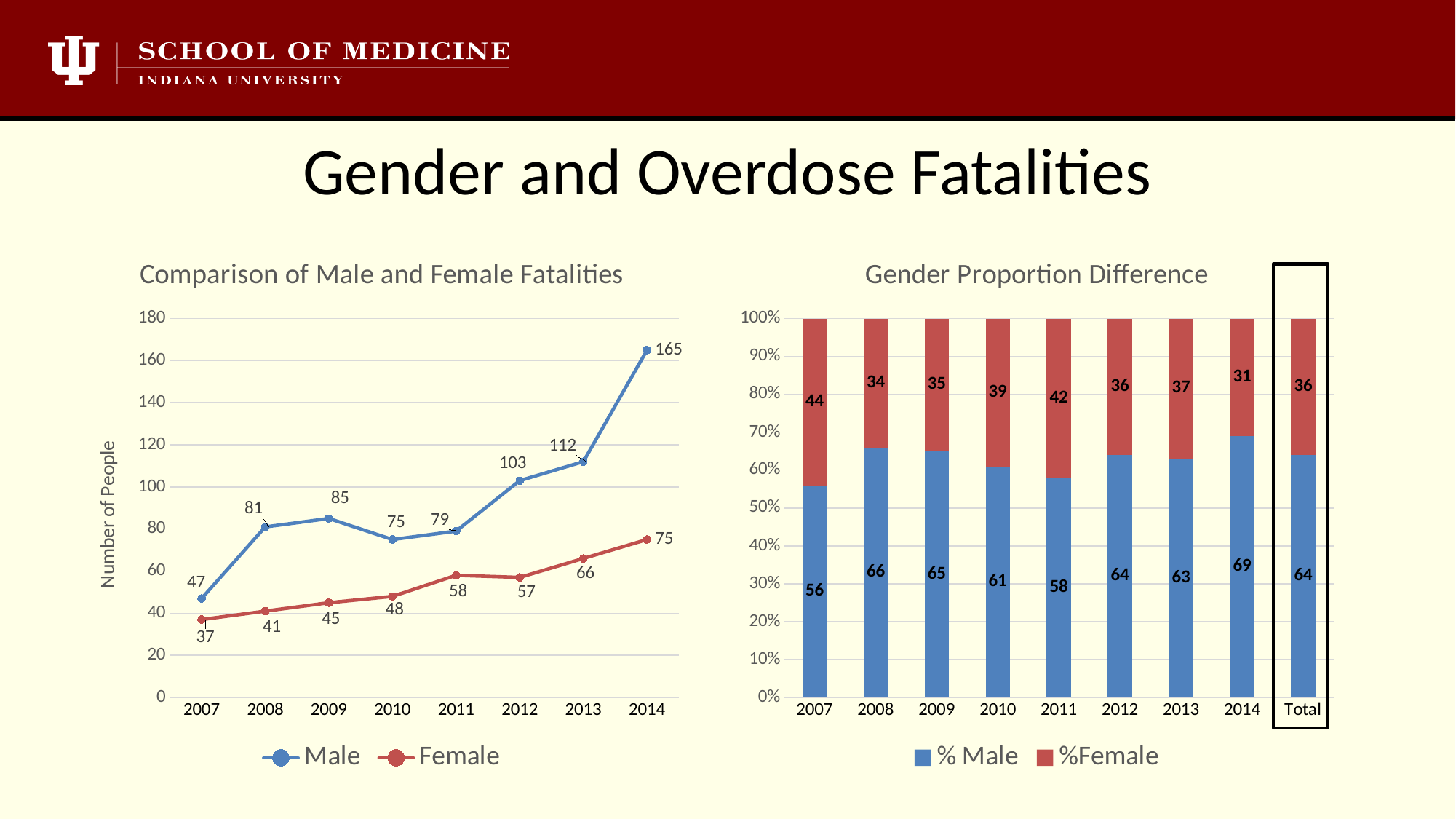
In the 'Comparison of Male and Female Fatalities' chart, which year has the lowest Male value? 2007 In the 'Gender Proportion Difference' chart, what is the %Female value for the Total bar? 36 In the 'Gender Proportion Difference' chart, which year has the highest % Female value? 2007 In the 'Comparison of Male and Female Fatalities' chart, does the Female series rise or fall from 2007 to 2014? Rise In the 'Comparison of Male and Female Fatalities' chart, what is the difference between the Male and Female values in 2013? 46 In the 'Comparison of Male and Female Fatalities' chart, what is the Male value for 2014? 165 How many series does the legend of the 'Gender Proportion Difference' chart list? 2 What kind of chart is 'Comparison of Male and Female Fatalities'? Line chart In the 'Comparison of Male and Female Fatalities' chart, how many years are shown on the x axis? 8 In the 'Gender Proportion Difference' chart, what is the % Male value for 2011? 58 In the 'Comparison of Male and Female Fatalities' chart, which is larger in 2009: the Male value or the Female value? Male In the 'Comparison of Male and Female Fatalities' chart, what is the Female value for 2010? 48